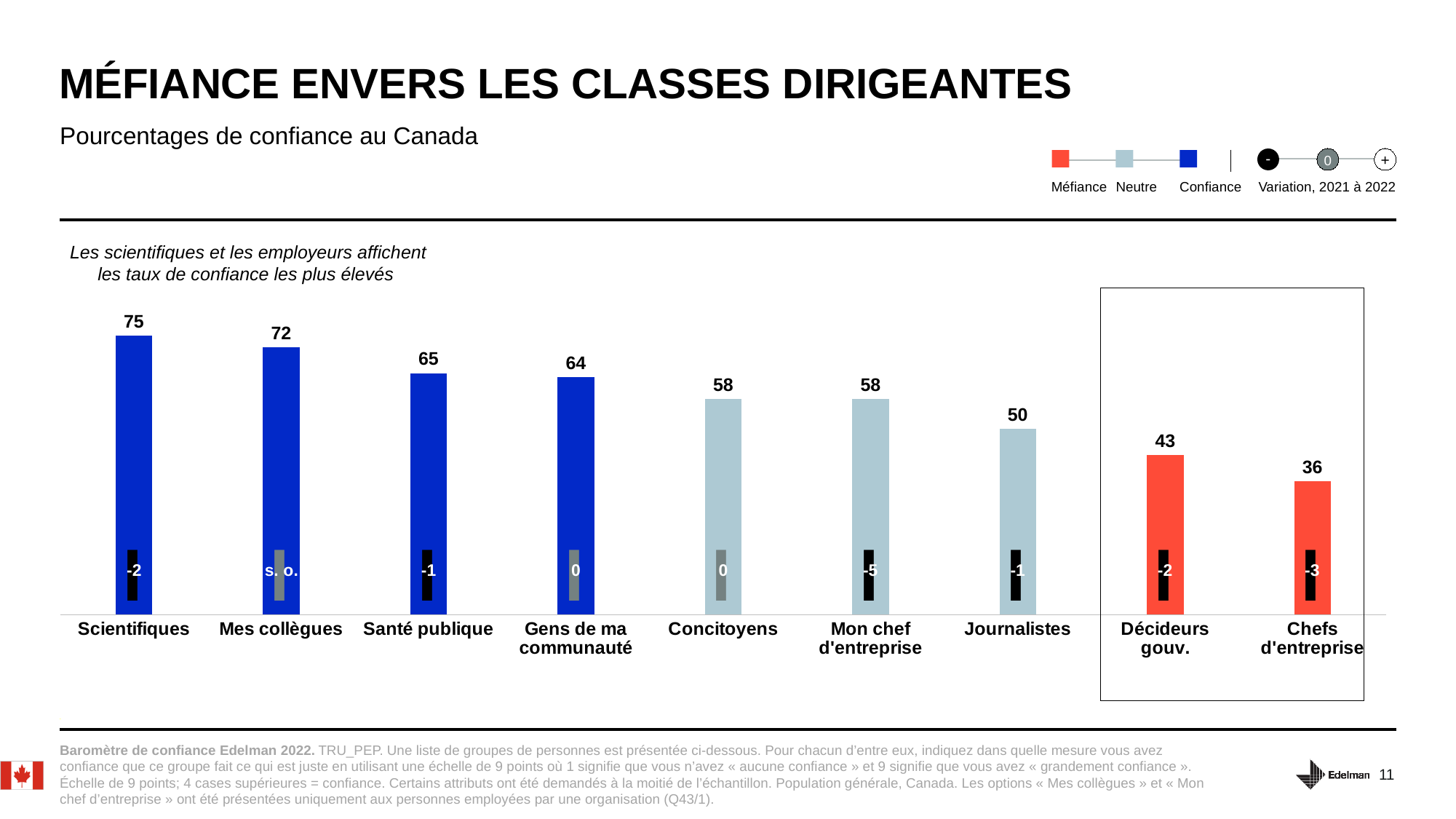
What kind of chart is shown on the slide? Bar chart How many categories are shown on the chart? 9 What is the variation from 2021 to 2022 shown for Mon chef d'entreprise? -5 Which has a higher trust percentage, Mes collègues or Santé publique? Mes collègues What is the difference between the trust percentages for Décideurs gouv. and Chefs d'entreprise? 7 What is the trust percentage for Scientifiques? 75 Which category has the lowest trust percentage? Chefs d'entreprise Which colour does the legend assign to 'Méfiance'? Red What is the trust percentage for Journalistes? 50 What is the difference between the trust percentages for Scientifiques and Chefs d'entreprise? 39 What is the trust percentage for Chefs d'entreprise? 36 Which category has the highest trust percentage? Scientifiques